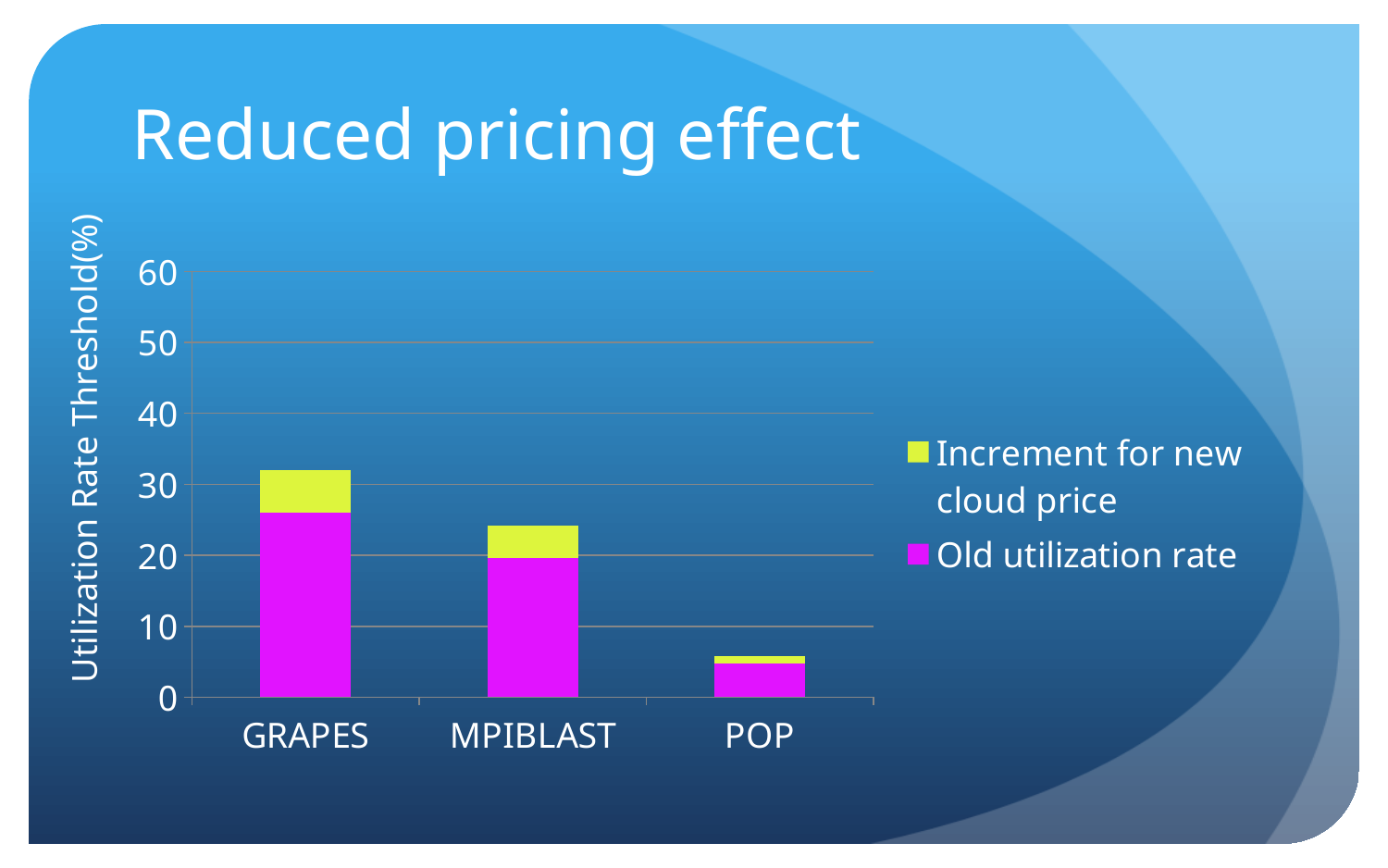
How many categories are shown on the x axis? 3 Is the total stacked value for GRAPES greater or less than 40? less Which has a larger Old utilization rate, GRAPES or MPIBLAST? GRAPES Is the Old utilization rate for GRAPES greater or less than 20? greater Is the total stacked value for POP greater or less than 10? less Do the stacked bar totals rise or fall from GRAPES to POP along the x axis? fall Which category has the shortest stacked bar? POP Which category has the tallest stacked bar? GRAPES What kind of chart is shown on the slide? stacked bar chart How many series does the legend list? 2 What is the title of the chart? Reduced pricing effect What is the label of the vertical axis? Utilization Rate Threshold(%)